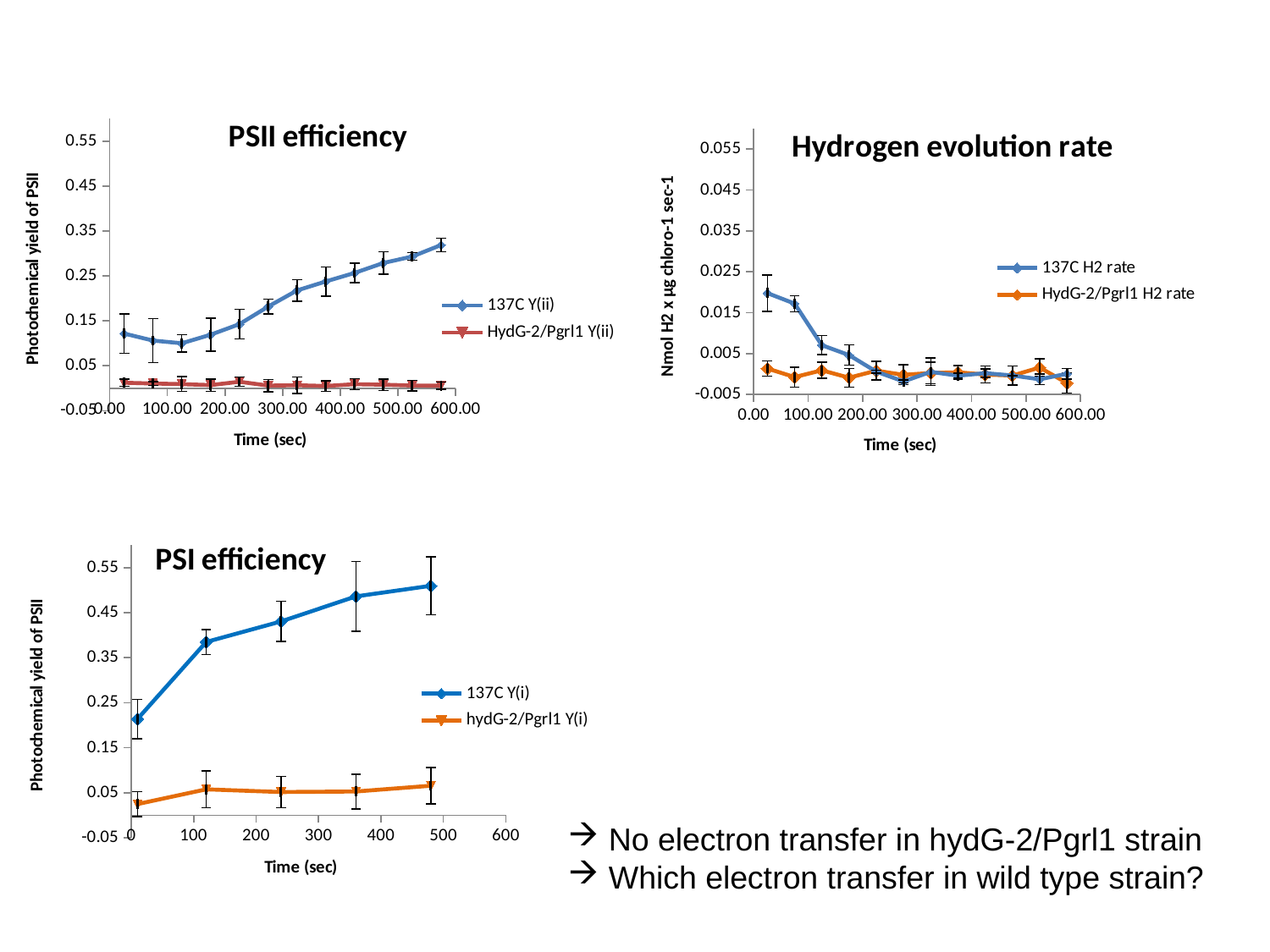
In the Hydrogen evolution rate chart, is the first value of the 137C H2 rate series greater or less than 0.015? greater How many series does the legend of the Hydrogen evolution rate chart list? 2 In the PSII efficiency chart, does the 137C Y(ii) series rise or fall as time increases? rise In the PSII efficiency chart, which series has the larger value at 575 sec, 137C Y(ii) or HydG-2/Pgrl1 Y(ii)? 137C Y(ii) In the PSI efficiency chart, is the value for 137C Y(i) at 480 sec greater or less than 0.45? greater How many data points does the 137C Y(i) series have in the PSI efficiency chart? 5 What is the y-axis label of the Hydrogen evolution rate chart? Nmol H2 x µg chloro-1 sec-1 In the PSI efficiency chart, which series has the larger value at 480 sec, 137C Y(i) or hydG-2/Pgrl1 Y(i)? 137C Y(i) What kind of chart is the PSII efficiency chart? line chart In the PSI efficiency chart, does the 137C Y(i) series rise or fall as time increases? rise In the Hydrogen evolution rate chart, does the 137C H2 rate series rise or fall as time increases? fall